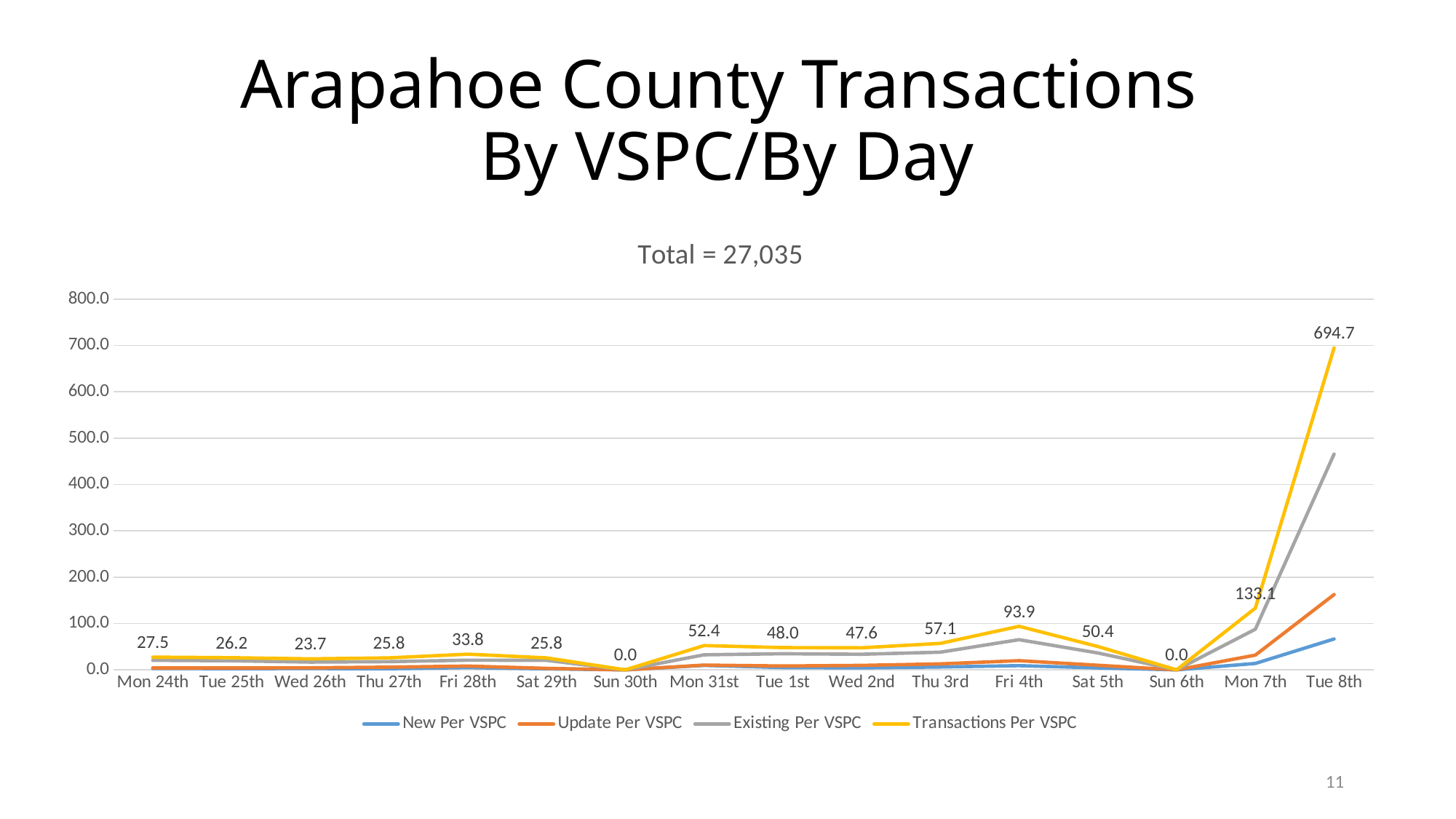
How many days are plotted along the x axis? 16 What total is stated above the chart? Total = 27,035 What is the Transactions Per VSPC value on Mon 7th? 133.1 What is the Transactions Per VSPC value on Tue 8th? 694.7 What is the Transactions Per VSPC value on Fri 4th? 93.9 What is the difference between the Transactions Per VSPC values on Tue 8th and Mon 7th? 561.6 How many series does the legend list? 4 What is the lowest Transactions Per VSPC value shown on the chart? 0.0 Which is larger, the Transactions Per VSPC value on Mon 31st or on Tue 1st? Mon 31st On which day is Transactions Per VSPC highest? Tue 8th Is the Existing Per VSPC value on Tue 8th greater or less than 400? greater What type of chart is shown on the slide? line chart